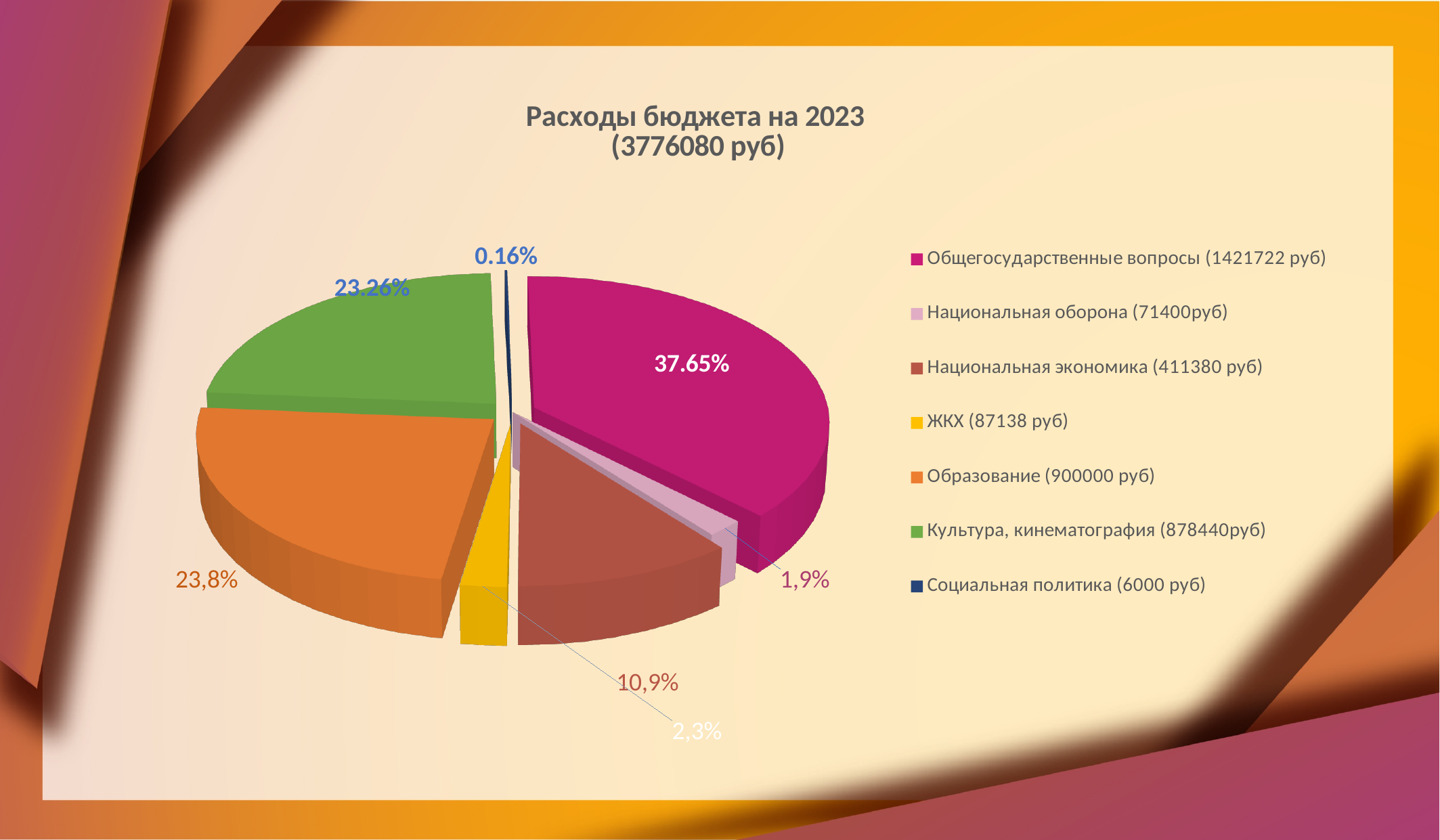
What share of the pie does Национальная экономика take? 10,9% What share of the pie does Культура, кинематография take? 23.26% Which category has the largest slice of the pie? Общегосударственные вопросы Which slice is larger: Образование or Культура, кинематография? Образование Which category has the smallest slice of the pie? Социальная политика What share of the pie does Социальная политика take? 0.16% What kind of chart is shown on the slide? pie chart According to the legend, what is the amount in rubles for ЖКХ? 87138 руб How many categories does the pie chart have? 7 What is the title of the chart? Расходы бюджета на 2023 (3776080 руб) According to the legend, what is the amount in rubles for Образование? 900000 руб